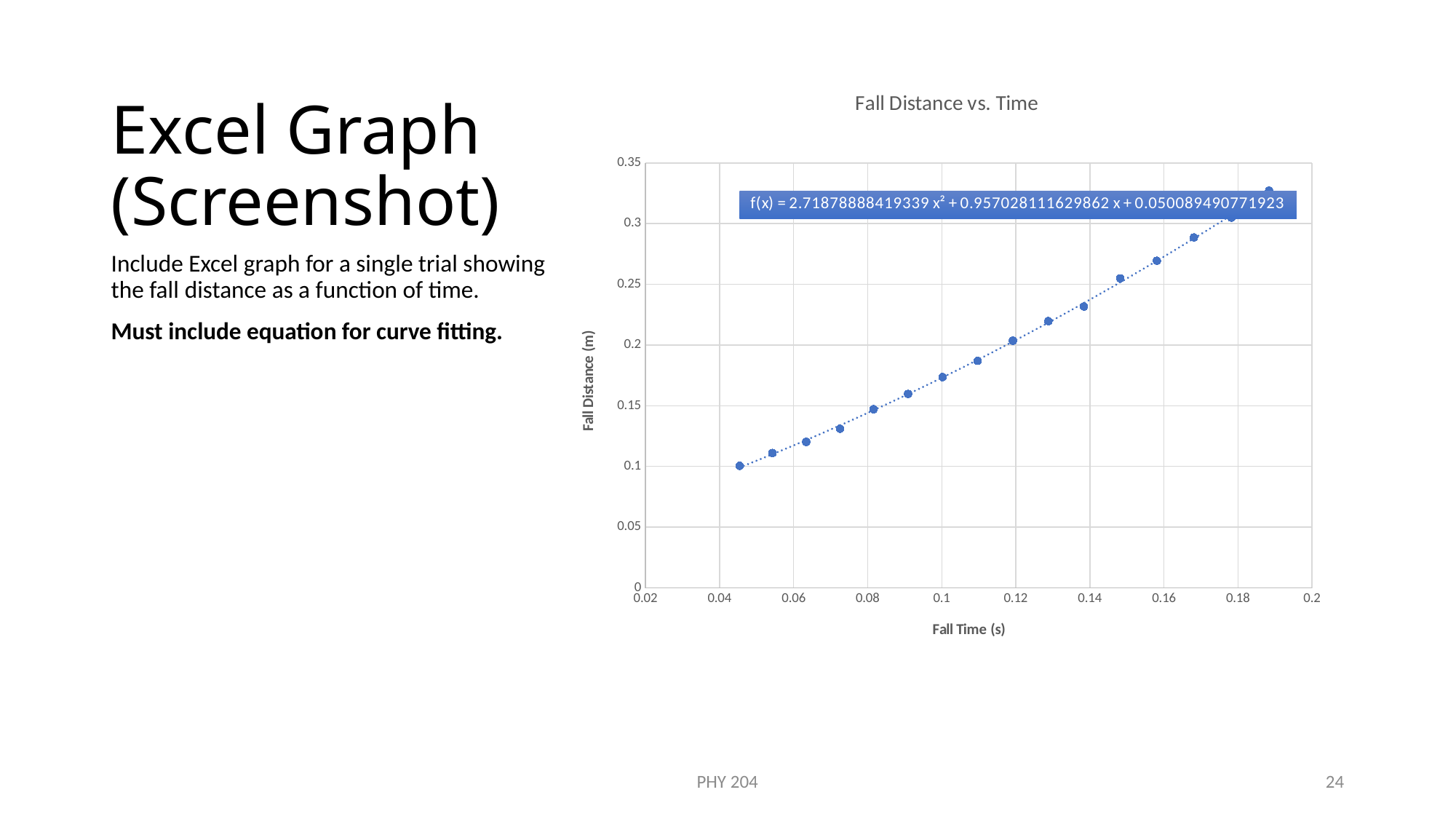
Is the fall distance of the leftmost data point greater or less than 0.15 m? less Is the fall distance at a fall time of 0.1 s greater or less than 0.15 m? greater Do the fall distance values rise or fall as fall time increases along the x axis? Rise Is the fall distance at a fall time of about 0.14 s greater or less than 0.2 m? greater Which has the larger fall distance: the point at about 0.18 s or the point at 0.1 s? The point at about 0.18 s What is the coefficient of x² in the curve-fitting equation shown on the chart? 2.71878888419339 What is the label of the y axis? Fall Distance (m) What kind of chart is shown on the slide? Scatter chart What is the title of the chart? Fall Distance vs. Time Does the highest fall distance occur at the smallest or the largest fall time? The largest fall time